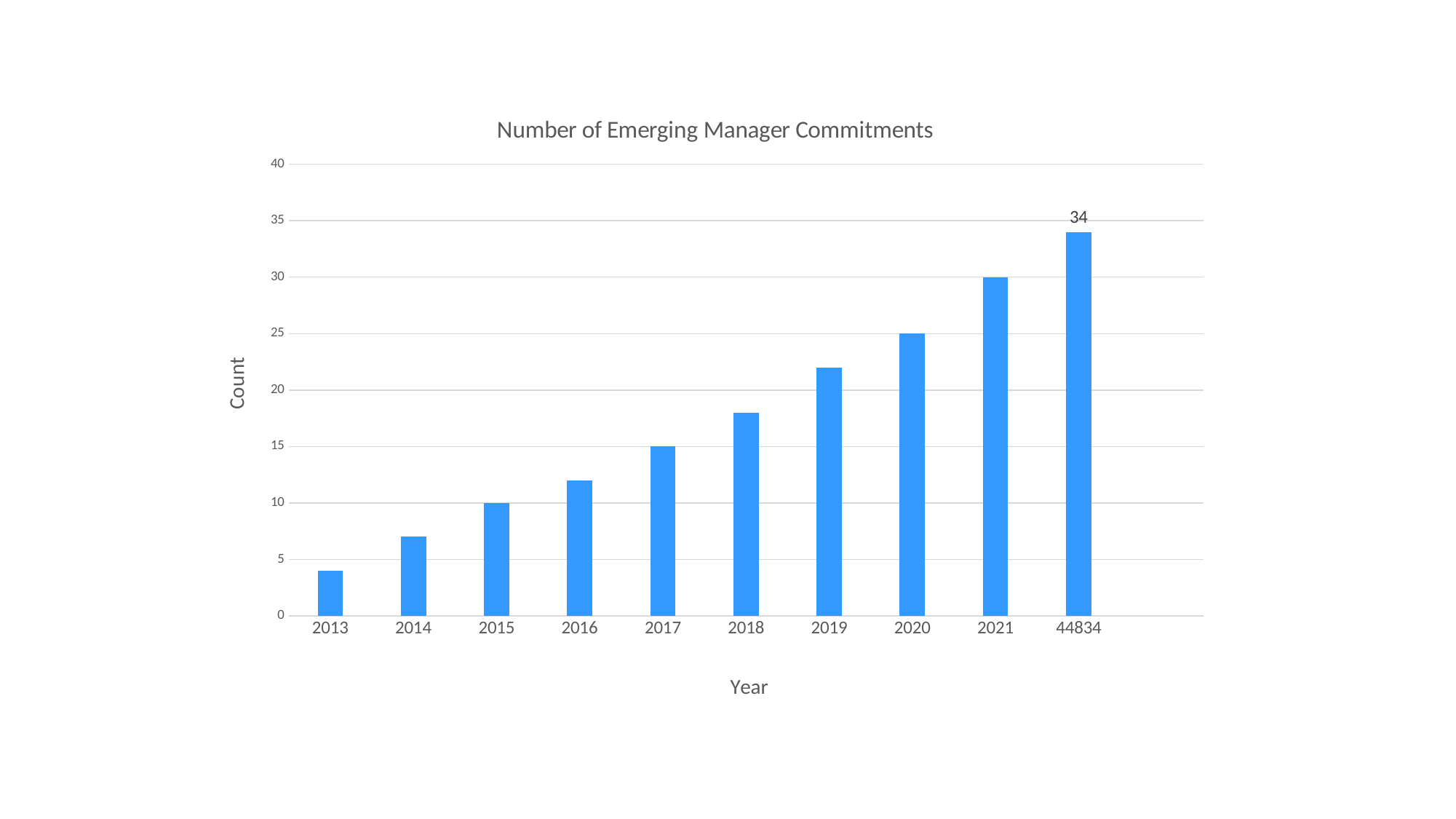
Is the value for 2019 greater or less than 20? greater What is the difference between the value for 44834 and the value for 2021? 4 What kind of chart is this? bar chart How many bars are shown in the chart? 10 What is the value for 2015? 10 Which category has the highest value? 44834 Do the values rise or fall from 2013 to the last bar? rise What is the value for 2021? 30 Which year has the lowest value? 2013 What is the value of the bar labelled 44834? 34 Which is larger, the value for 2019 or the value for 2018? 2019 Is the value for 2014 greater or less than 10? less